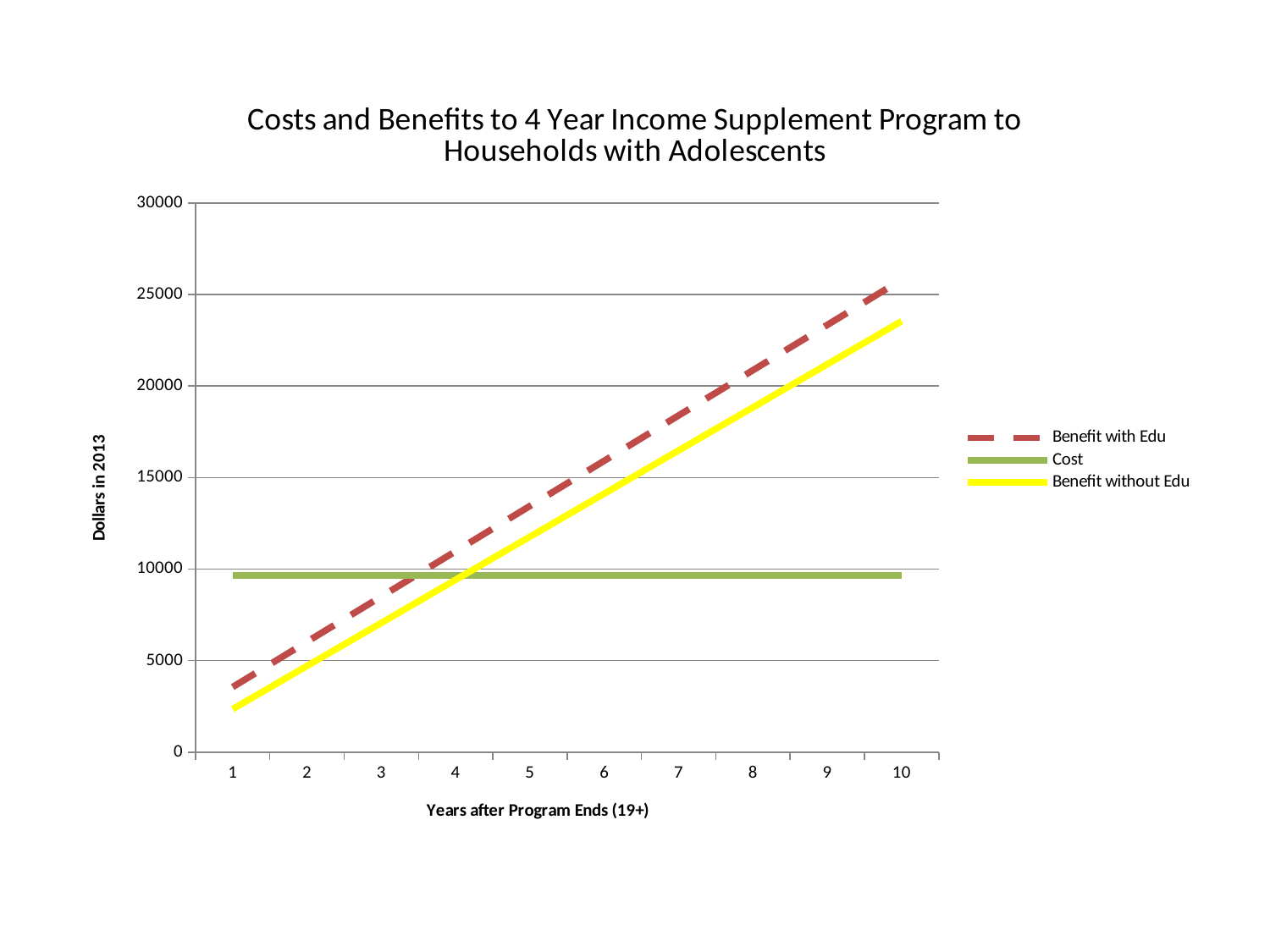
What kind of chart is shown on the slide? line chart Does the Cost line rise, fall, or stay flat across the years? stays flat Is the value for Benefit without Edu at year 1 greater or less than 5000? less How many years are shown along the x axis? 10 Which series is drawn with a dashed line? Benefit with Edu What is the title of the chart? Costs and Benefits to 4 Year Income Supplement Program to Households with Adolescents How many series does the legend list? 3 Is the value for Benefit with Edu at year 10 greater or less than 20000? greater At year 1, which is higher: Cost or Benefit with Edu? Cost At year 10, which is higher: Benefit with Edu or Benefit without Edu? Benefit with Edu Does the Benefit with Edu line rise or fall as the years after the program ends increase? rise Is the value for Cost greater or less than 10000? less